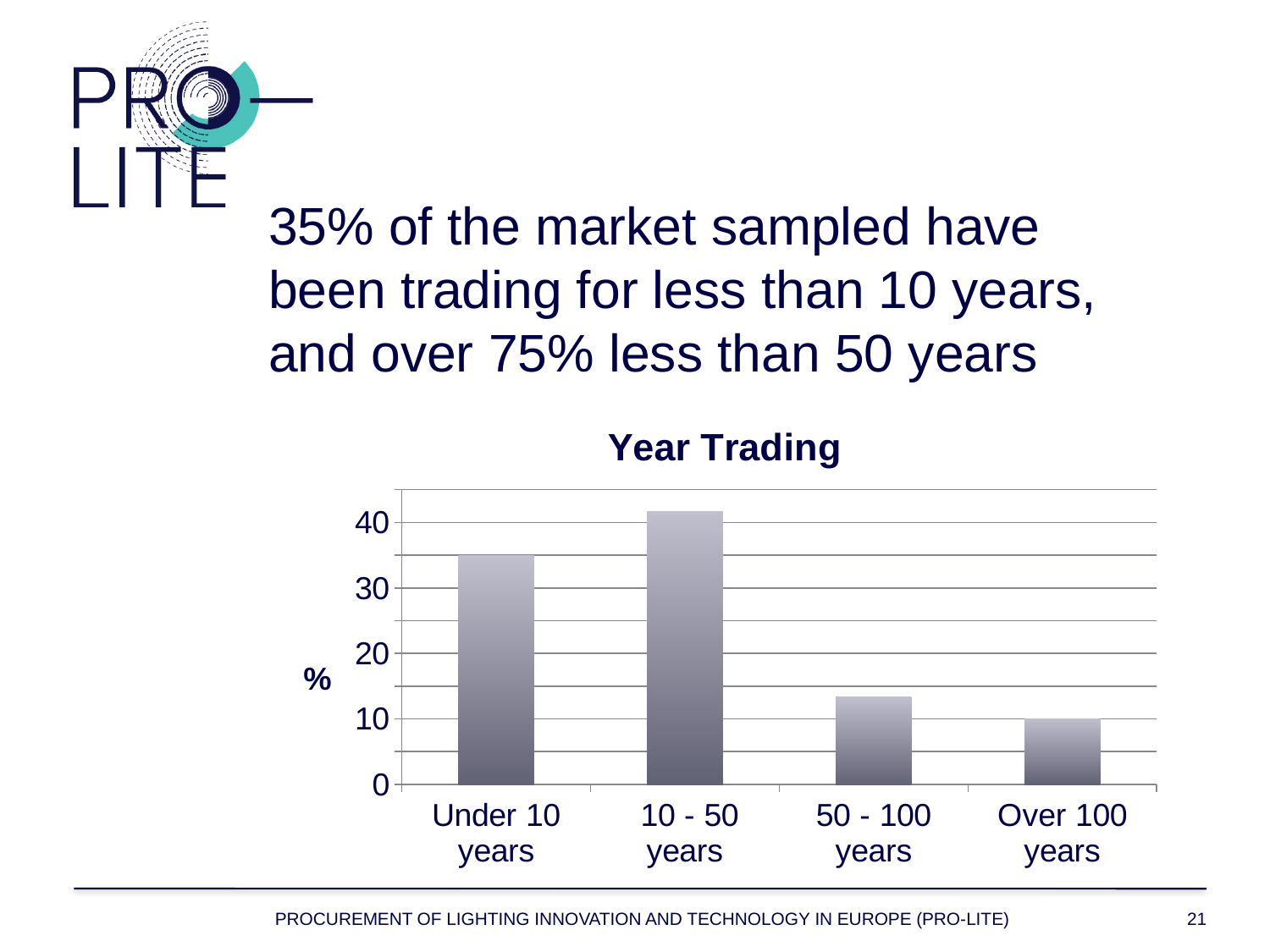
Is the value for Under 10 years greater or less than 30? greater How many categories are shown on the x axis of the chart? 4 What is the title of the chart? Year Trading Which category has the lowest value in the chart? Over 100 years What percentage of the market sampled has been trading for under 10 years? 35% What kind of chart is shown on the slide? bar chart Is the value for 50 - 100 years greater or less than 20? less What is the value for Over 100 years? 10 Which is larger, the value for Under 10 years or the value for 50 - 100 years? Under 10 years Is the value for 10 - 50 years greater or less than 40? greater Which category has the highest value in the chart? 10 - 50 years What label is shown on the y axis of the chart? %